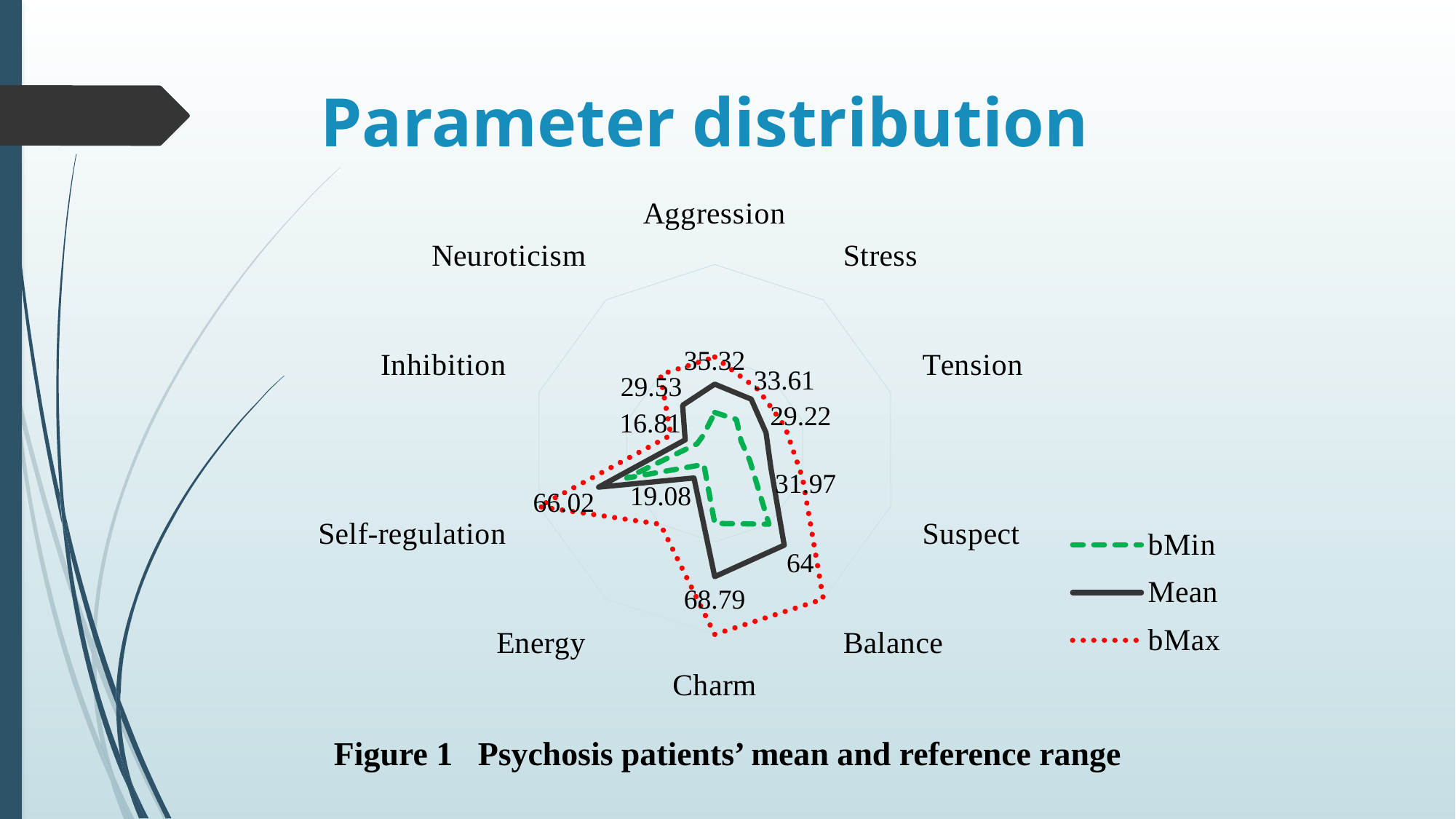
How many series does the legend list? 3 What is the Mean value for Balance? 64 How many categories (axes) does the radar chart have? 10 Which category has the lowest Mean value? Inhibition What is the Mean value for Charm? 68.79 Which category has the highest Mean value? Charm Which has the larger Mean value, Suspect or Neuroticism? Suspect What kind of chart is shown on the slide? Radar chart What is the difference between the Mean values for Stress and Tension? 4.39 What is the Mean value for Aggression? 35.32 What is the Mean value for Self-regulation? 66.02 Which series is drawn with a red dotted line? bMax